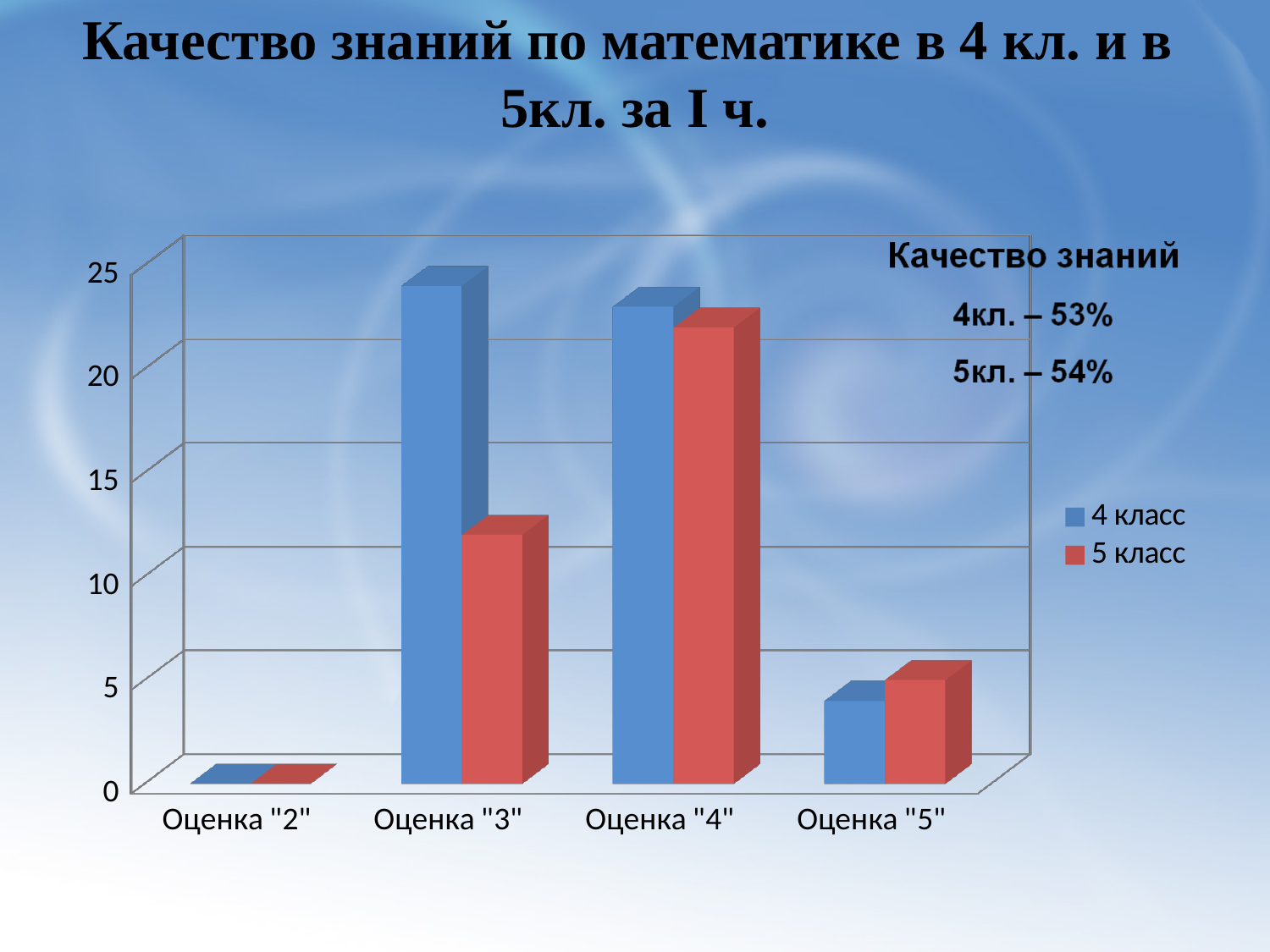
Is the value for 4 класс at Оценка "3" greater or less than 20? greater Is the value for 5 класс at Оценка "3" greater or less than 15? less For the 5 класс series, which category has the highest value? Оценка "4" What is the quality of knowledge percentage shown for 4 кл. in the text on the chart? 53% Is the value for 4 класс at Оценка "5" greater or less than 5? less How many series does the legend list? 2 For the 4 класс series, which category has the lowest value? Оценка "2" Which series does the red bar represent? 5 класс How many categories are shown on the x axis? 4 What kind of chart is shown on the slide? bar chart At Оценка "3", which series has the larger value, 4 класс or 5 класс? 4 класс